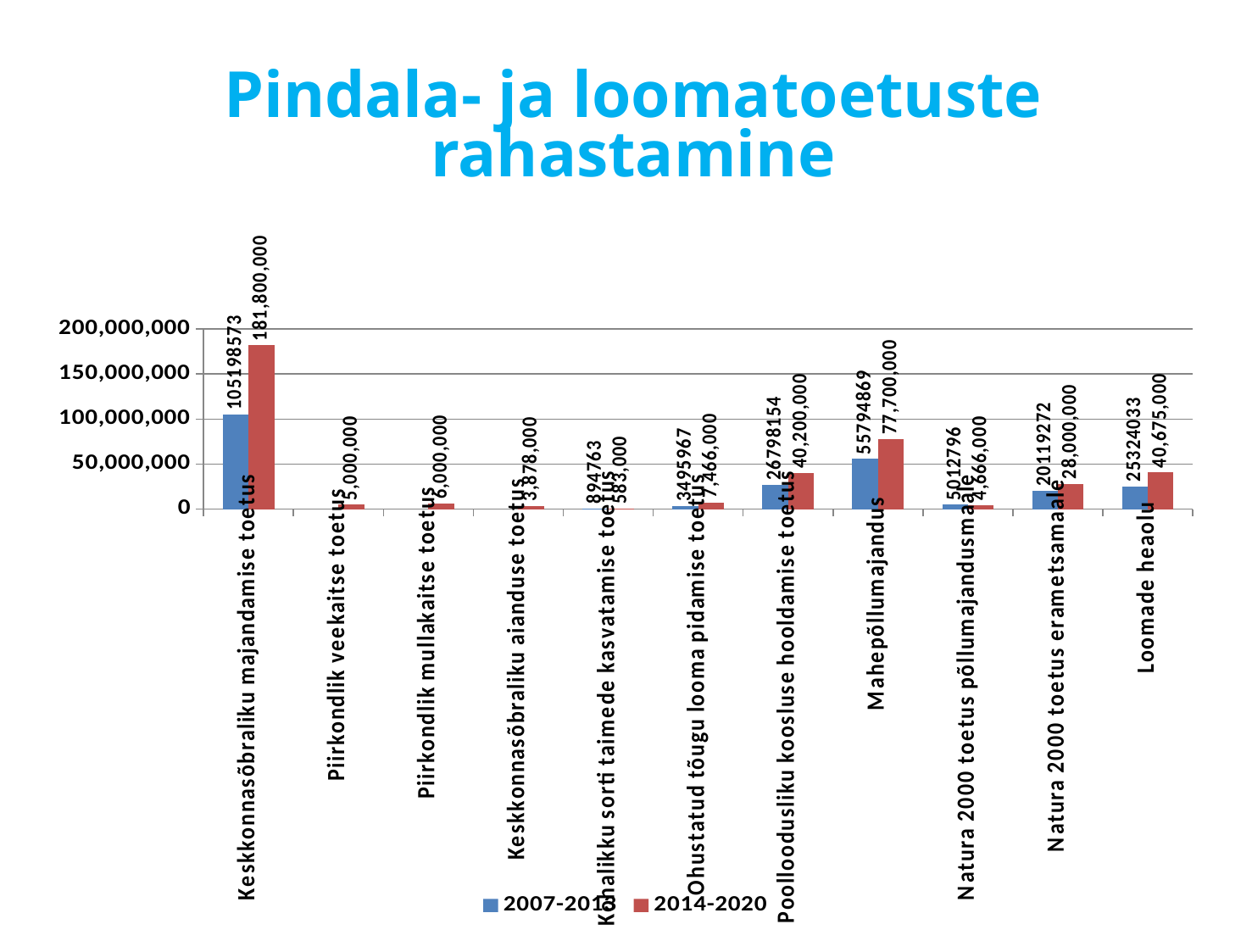
What is the difference between the 2014-2020 and 2007-2013 values for Mahepõllumajandus? 21,905,131 What is the 2007-2013 value for Loomade heaolu? 25324033 What is the 2014-2020 value for Natura 2000 toetus erametsamaale? 28,000,000 What is the title of the chart on the slide? Pindala- ja loomatoetuste rahastamine What is the 2014-2020 value for Mahepõllumajandus? 77,700,000 What is the 2014-2020 value for Piirkondlik mullakaitse toetus? 6,000,000 Which category has the highest 2014-2020 value? Keskkonnasõbraliku majandamise toetus How many categories are shown on the x axis? 11 What kind of chart is shown on the slide? Bar chart For Natura 2000 toetus põllumajandusmaale, which series has the larger value, 2007-2013 or 2014-2020? 2007-2013 How many series does the legend list? 2 Is the 2007-2013 value for Keskkonnasõbraliku majandamise toetus greater or less than 100,000,000? greater